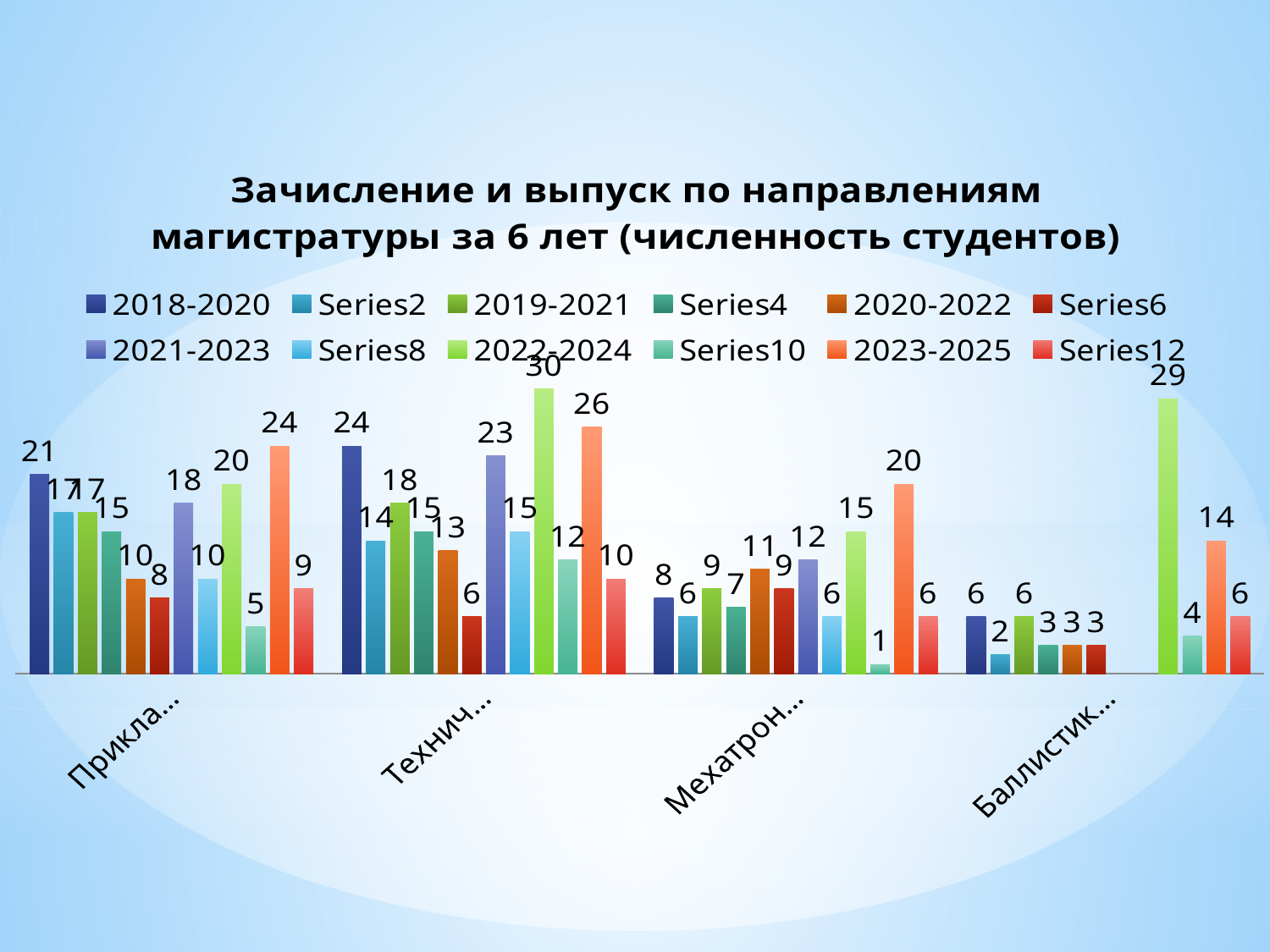
What is the value of the 2023-2025 series for the category "Мехатрон..."? 20 What is the difference between the 2023-2025 values for "Технич..." and "Прикла..."? 2 Which category has the highest value for the 2022-2024 series? Технич... What is the title of the chart? Зачисление и выпуск по направлениям магистратуры за 6 лет (численность студентов) What is the value of the 2022-2024 series for the category "Баллистик..."? 29 What is the value of the Series10 bar for the category "Прикла..."? 5 How many series does the legend list? 12 Which category has the larger 2018-2020 value, "Прикла..." or "Технич..."? Технич... How many categories are shown along the x axis? 4 What kind of chart is shown on the slide? bar chart Which series has the lowest value in the "Мехатрон..." category? Series10 What is the value of the 2018-2020 series for the category "Технич..."? 24